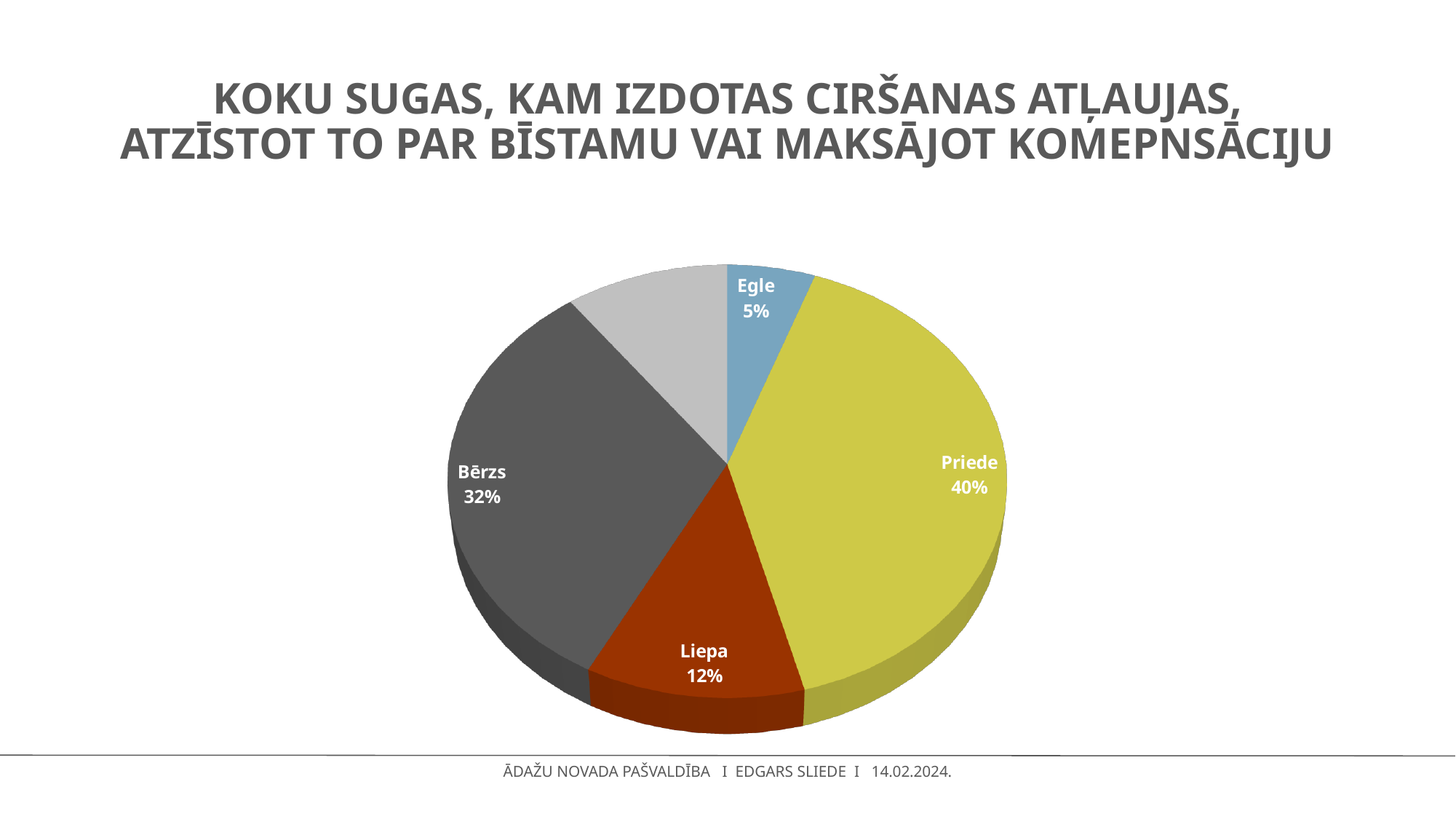
Which has a larger share, Liepa or Egle? Liepa By how many percentage points does Priede exceed Bērzs? 8 percentage points What percentage of the pie does Priede account for? 40% What is the difference in percentage points between Bērzs and Liepa? 20 percentage points What share of the pie is Egle? 5% What kind of chart is shown on the slide? Pie chart What percentage is labelled for Liepa? 12% Which tree species has the largest slice of the pie? Priede What colour is the Priede slice? Yellow Which labelled tree species has the smallest slice of the pie? Egle What share is shown for Bērzs? 32% How many slices does the pie chart have? 5